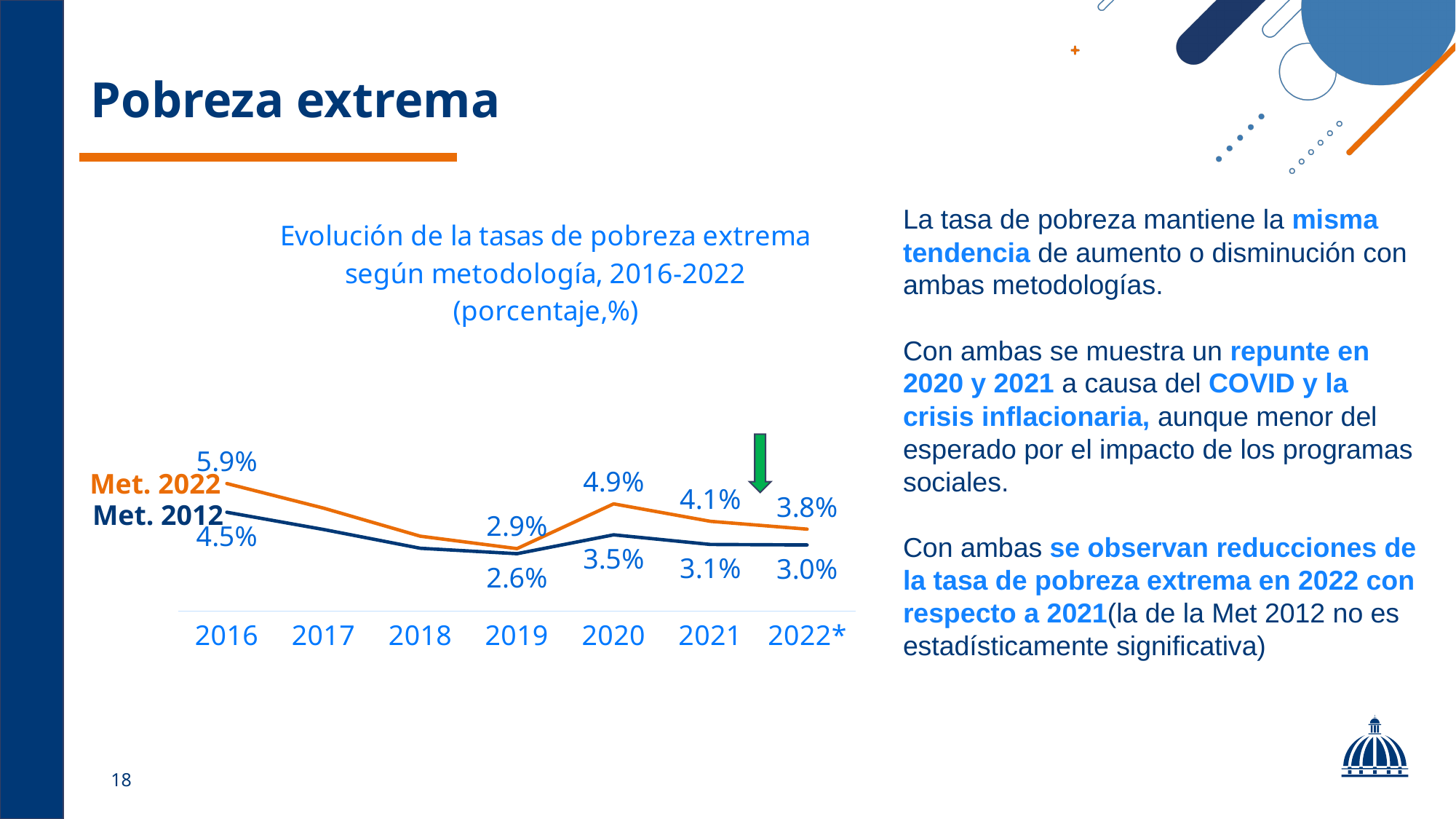
By how much did the Met. 2022 rate fall from 2020 to 2022*? 1.1% What is the Met. 2022 extreme poverty rate in 2020? 4.9% In which year is the Met. 2022 series at its highest labelled value? 2016 What is the Met. 2022 extreme poverty rate in 2016? 5.9% Which series has the higher value in 2020, Met. 2022 or Met. 2012? Met. 2022 What is the difference between the Met. 2022 and Met. 2012 values in 2021? 1.0% What is the Met. 2012 extreme poverty rate in 2022*? 3.0% What is the Met. 2012 extreme poverty rate in 2019? 2.6% How many years are shown on the x axis? 7 What type of chart is shown on the slide? Line chart How many series does the chart plot? 2 In which year is the Met. 2012 series at its lowest labelled value? 2019